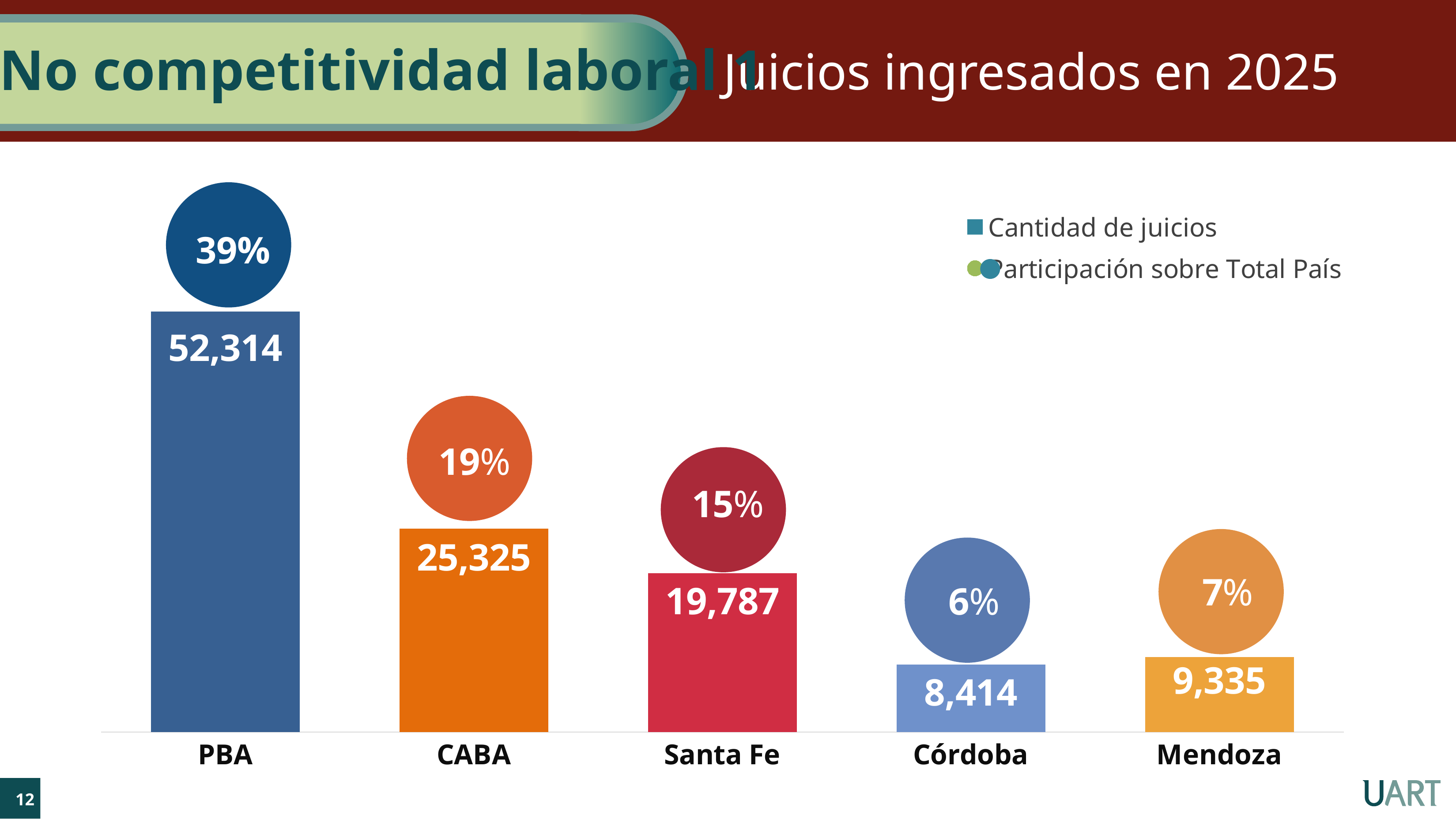
What is the number of juicios for Santa Fe? 19,787 Which province has the highest number of juicios? PBA Which province has the lowest number of juicios? Córdoba Which has more juicios, Mendoza or Córdoba? Mendoza What is the difference in number of juicios between PBA and CABA? 26,989 What is the difference in Participación sobre Total País between PBA and Santa Fe? 24% What is the Participación sobre Total País for Mendoza? 7% How many provinces are shown on the x axis? 5 What kind of chart is shown on the slide? Bar chart What is the Participación sobre Total País for CABA? 19% How many series does the legend list? 2 What is the number of juicios (Cantidad de juicios) for PBA? 52,314